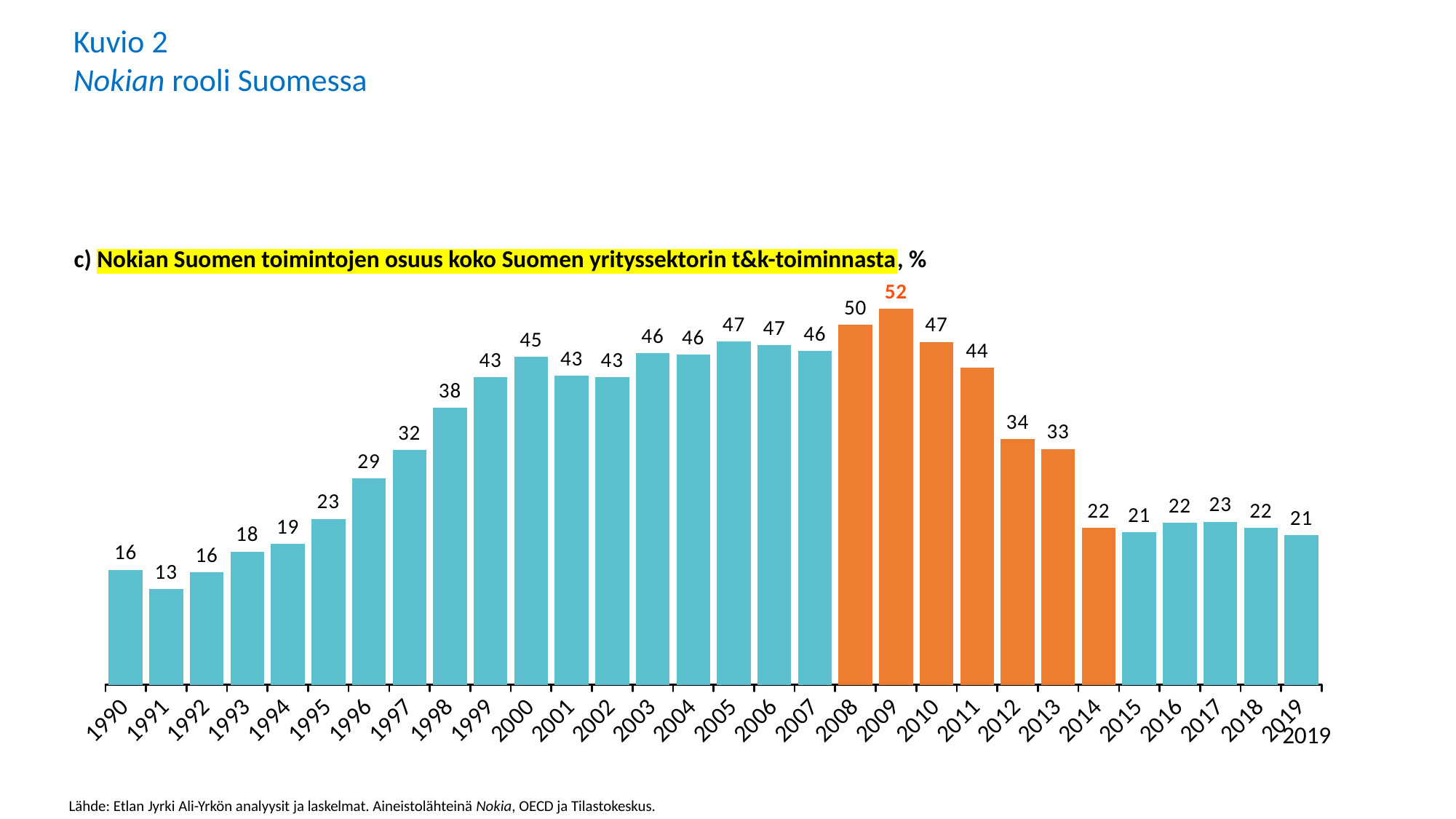
How many years (bars) are shown in the chart? 30 What is the difference between the values for 2009 and 2014? 30 What is the value for 2014? 22 What kind of chart is shown on the slide? Bar chart Do the values rise or fall from 2009 to 2014? Fall What is the value for 2009? 52 What is the value for 1990? 16 Which year has the highest value? 2009 Which is larger, the value for 2011 or the value for 2012? 2011 Which year has the lowest value? 1991 Which years are shown with orange bars? 2008 to 2014 What is the difference between the values for 2000 and 1990? 29